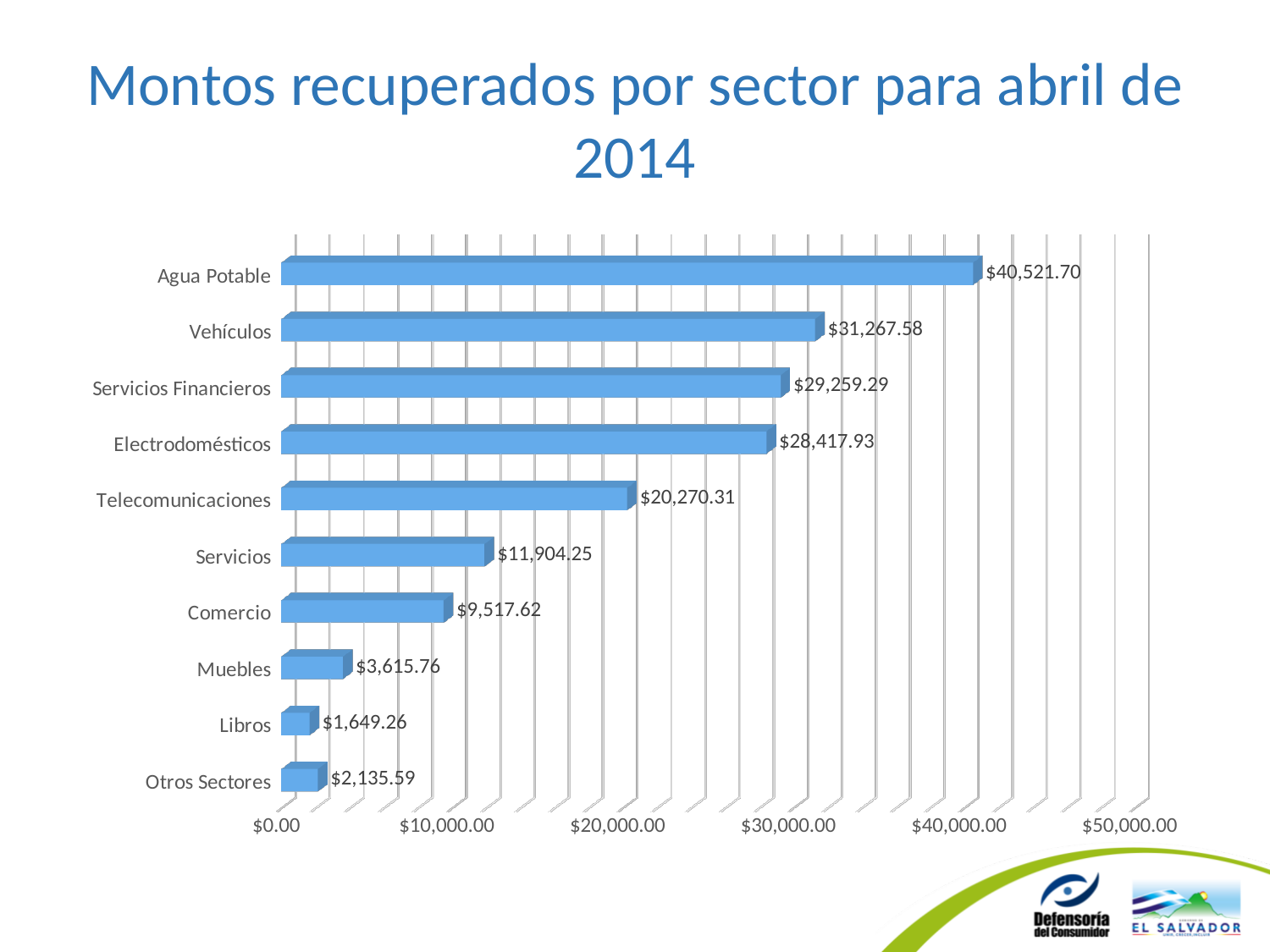
What is the title of the slide? Montos recuperados por sector para abril de 2014 What is the value for Libros? $1,649.26 What is the difference between the values for Otros Sectores and Libros? $486.33 How many sectors are shown in the chart? 10 What is the value for Agua Potable? $40,521.70 Which is larger, the value for Servicios Financieros or the value for Electrodomésticos? Servicios Financieros Which sector has the highest recovered amount? Agua Potable Is the value for Comercio greater or less than $10,000.00? less What kind of chart is shown on the slide? bar chart What is the difference between the values for Agua Potable and Vehículos? $9,254.12 Which sector has the lowest recovered amount? Libros What is the value for Telecomunicaciones? $20,270.31